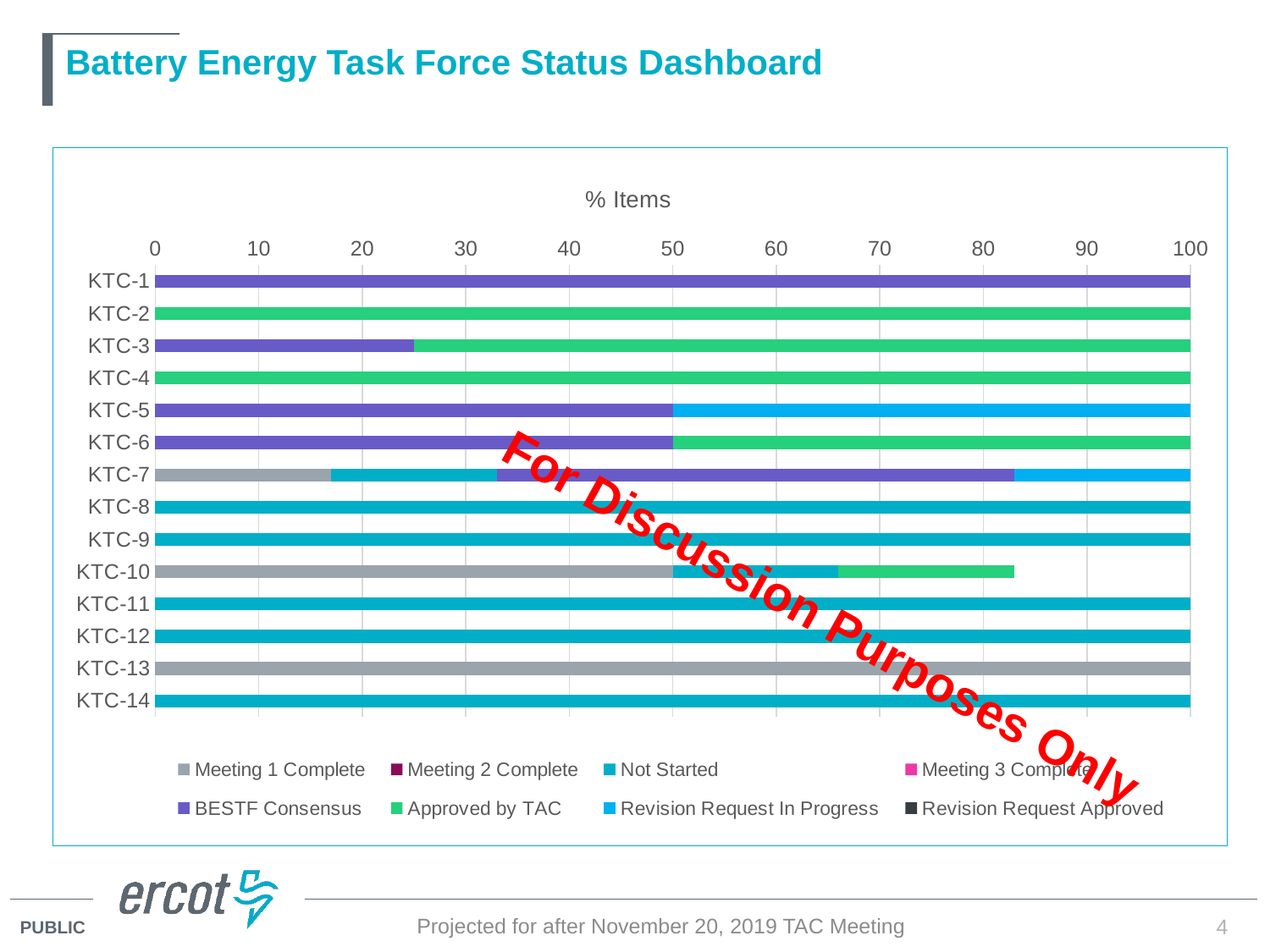
How many series does the chart legend list? 8 What is the Meeting 1 Complete value for KTC-10? 50 Is the Meeting 1 Complete value for KTC-7 greater or less than 20? less Which KTC category has the largest Meeting 1 Complete segment? KTC-13 What is the Meeting 1 Complete value for KTC-13? 100 What is the BESTF Consensus value for KTC-5? 50 What is the title shown above the chart's axis? % Items What is the BESTF Consensus value for KTC-1? 100 How many KTC categories are plotted on the chart? 14 Is the BESTF Consensus value for KTC-3 greater or less than 30? less What kind of chart is shown on the slide? Stacked bar chart Which is larger, the BESTF Consensus value for KTC-3 or for KTC-5? KTC-5